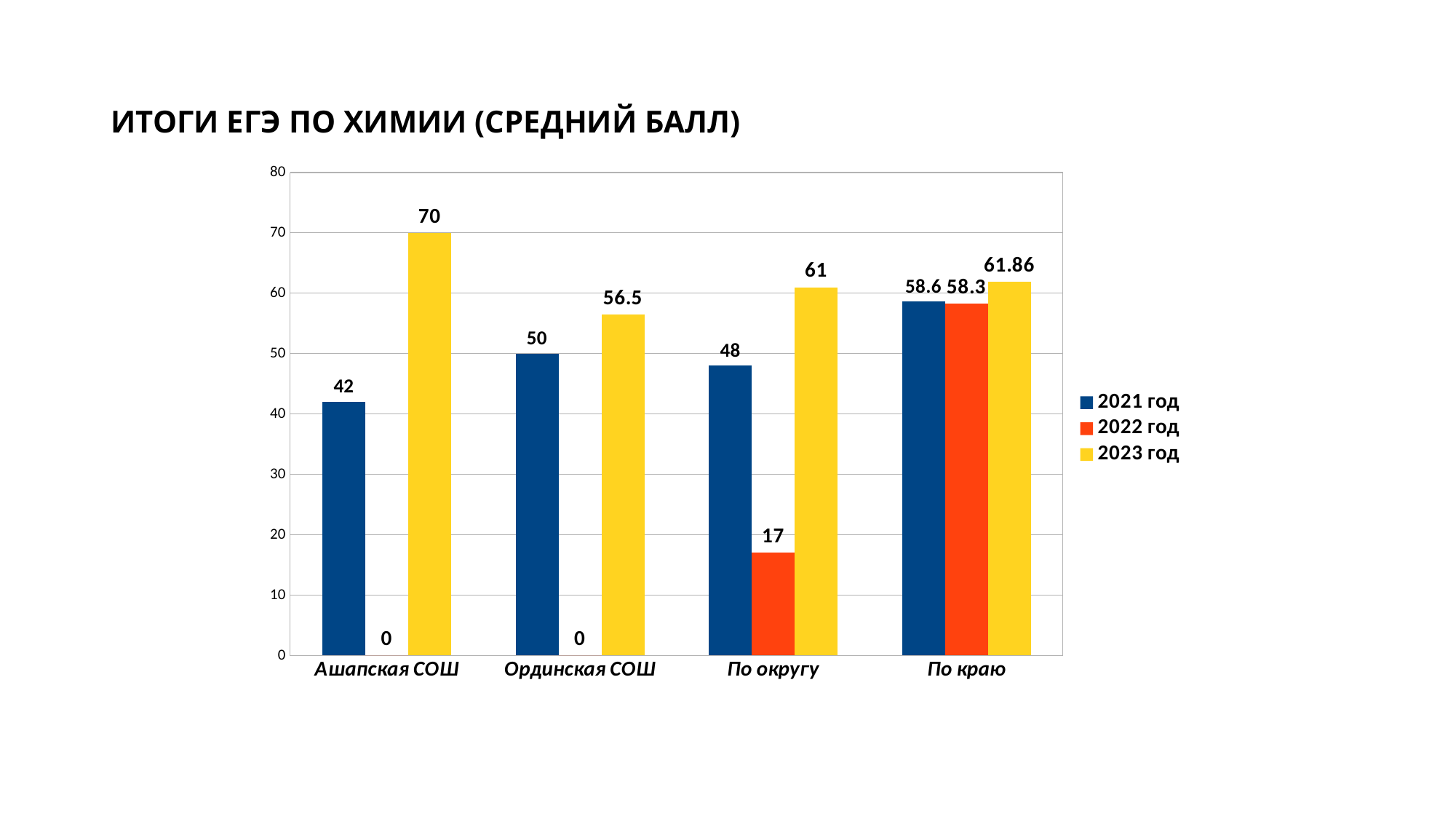
What is the value for По краю in 2022 год? 58.3 What is the value for По округу in 2022 год? 17 What is the value for Ашапская СОШ in 2023 год? 70 What kind of chart is shown on the slide? Bar chart What is the title of the slide? ИТОГИ ЕГЭ ПО ХИМИИ (СРЕДНИЙ БАЛЛ) Which category has the highest value in the 2023 год series? Ашапская СОШ What is the value for Ординская СОШ in 2021 год? 50 Which category has the lowest value in the 2021 год series? Ашапская СОШ How many categories are shown on the x axis? 4 What is the difference between the 2023 год and 2021 год values for Ашапская СОШ? 28 How many series does the legend list? 3 Which is larger: the 2023 год value for Ординская СОШ or the 2023 год value for По округу? По округу